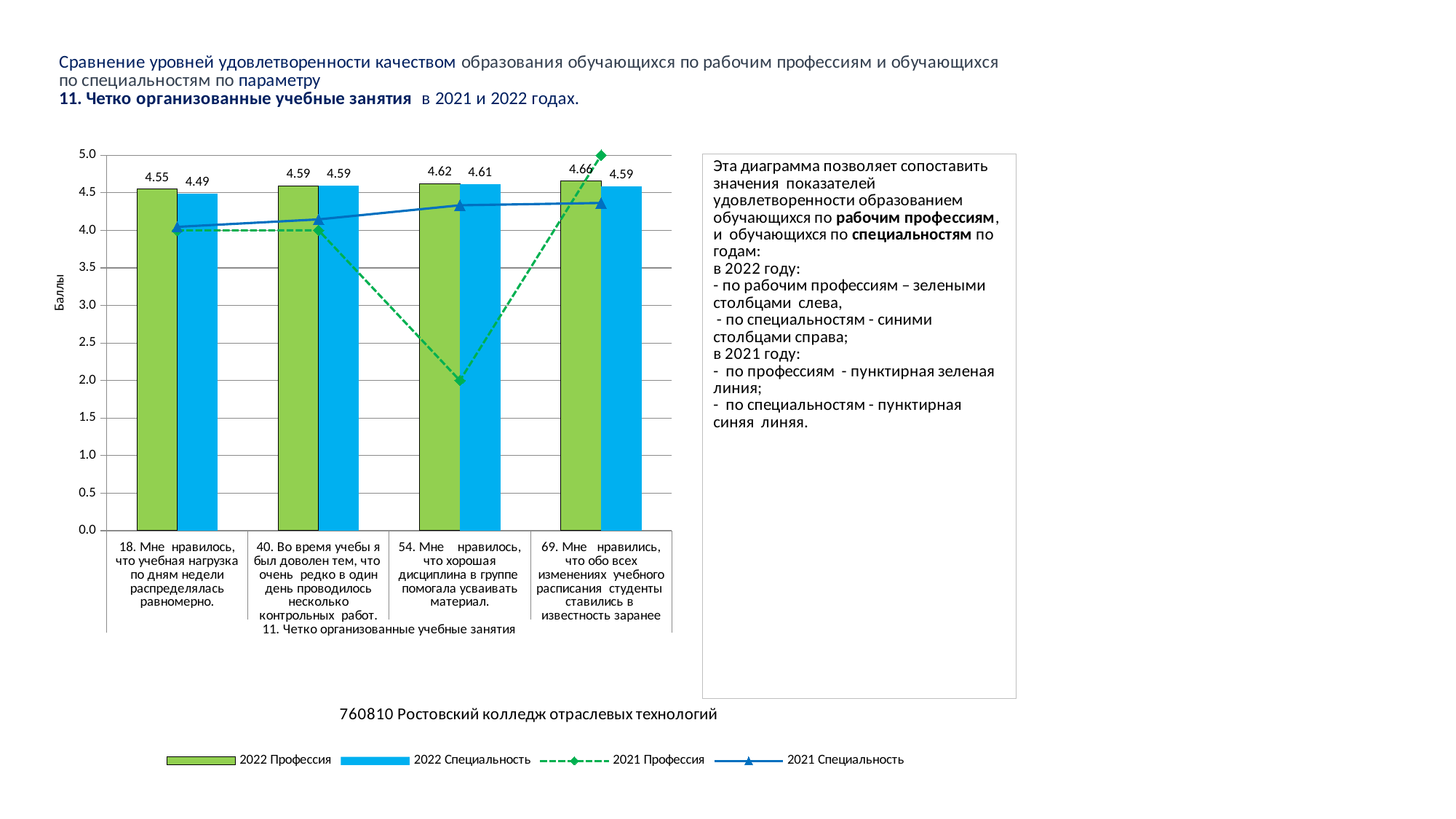
What is the value of the 2022 Профессия bar for question 18 (Мне нравилось, что учебная нагрузка по дням недели распределялась равномерно)? 4.55 How many series does the legend list? 4 What is the value of the 2022 Специальность bar for question 54 (Мне нравилось, что хорошая дисциплина в группе помогала усваивать материал)? 4.61 Which question has the highest 2022 Профессия bar? 69. Мне нравились, что обо всех изменениях учебного расписания студенты ставились в известность заранее Which question has the lowest 2022 Специальность bar? 18. Мне нравилось, что учебная нагрузка по дням недели распределялась равномерно. What is the difference between the 2022 Профессия and 2022 Специальность values for question 69? 0.07 For question 18, which is larger: the 2022 Профессия value or the 2022 Специальность value? 2022 Профессия How many question categories are shown on the x axis? 4 Is the 2021 Профессия (dashed green line) value for question 69 greater or less than 4.5? greater What is the value of the 2022 Специальность bar for question 18 (Мне нравилось, что учебная нагрузка по дням недели распределялась равномерно)? 4.49 Is the 2021 Профессия (dashed green line) value for question 54 greater or less than 2.5? less What is the value of the 2022 Профессия bar for question 69 (Мне нравились, что обо всех изменениях учебного расписания студенты ставились в известность заранее)? 4.66